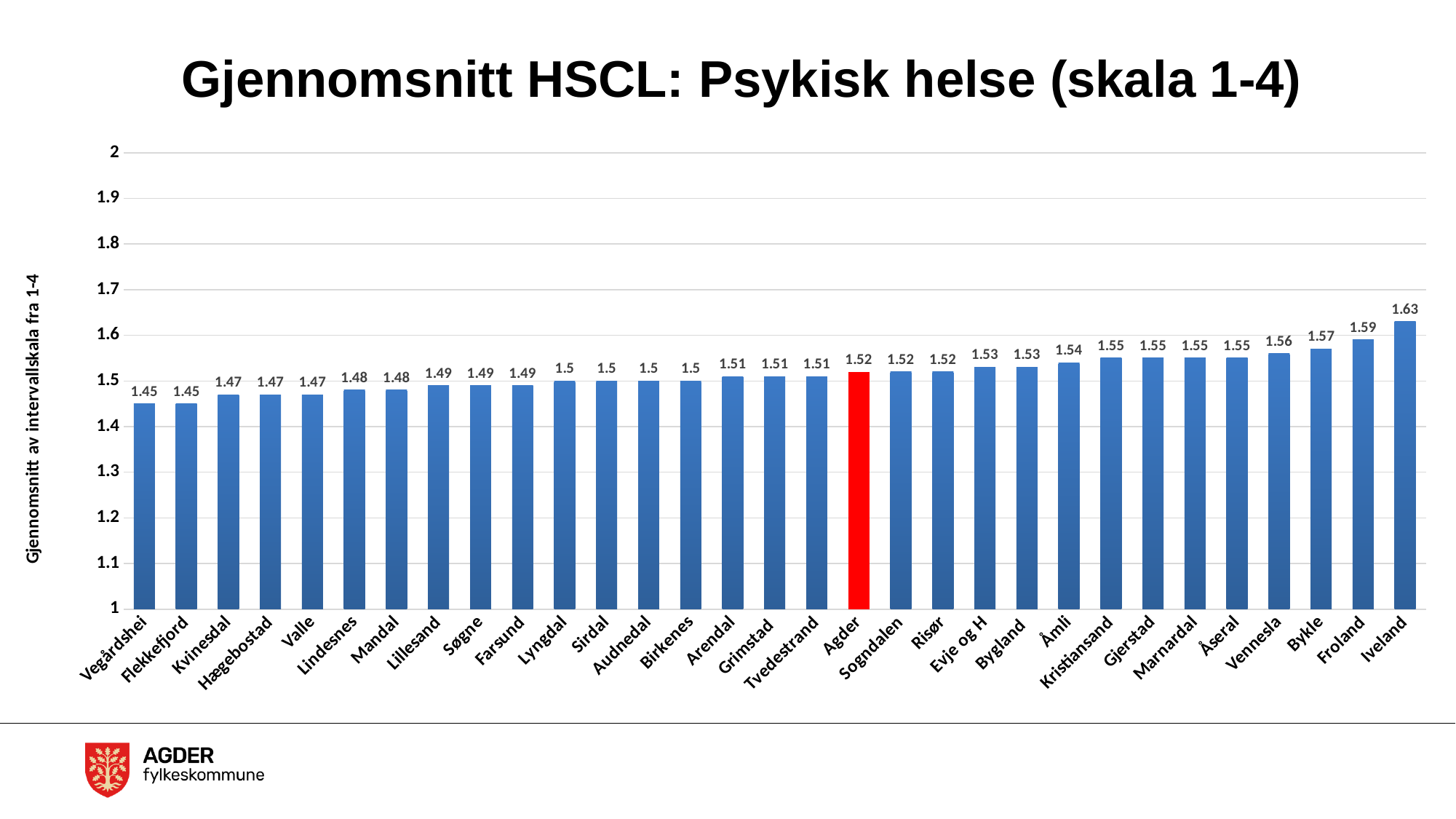
What kind of chart is this? bar chart Which category has the highest value? Iveland Is the value for Iveland greater or less than 1.6? greater Which bar is coloured red instead of blue? Agder What is the value for Kristiansand? 1.55 What is the lowest value shown in the chart? 1.45 What is the value for Lindesnes? 1.48 What is the value for Agder? 1.52 What is the difference between the values for Iveland and Vegårdshei? 0.18 How many categories are shown on the x axis? 31 What is the difference between the values for Froland and Agder? 0.07 Which has a larger value, Bykle or Arendal? Bykle